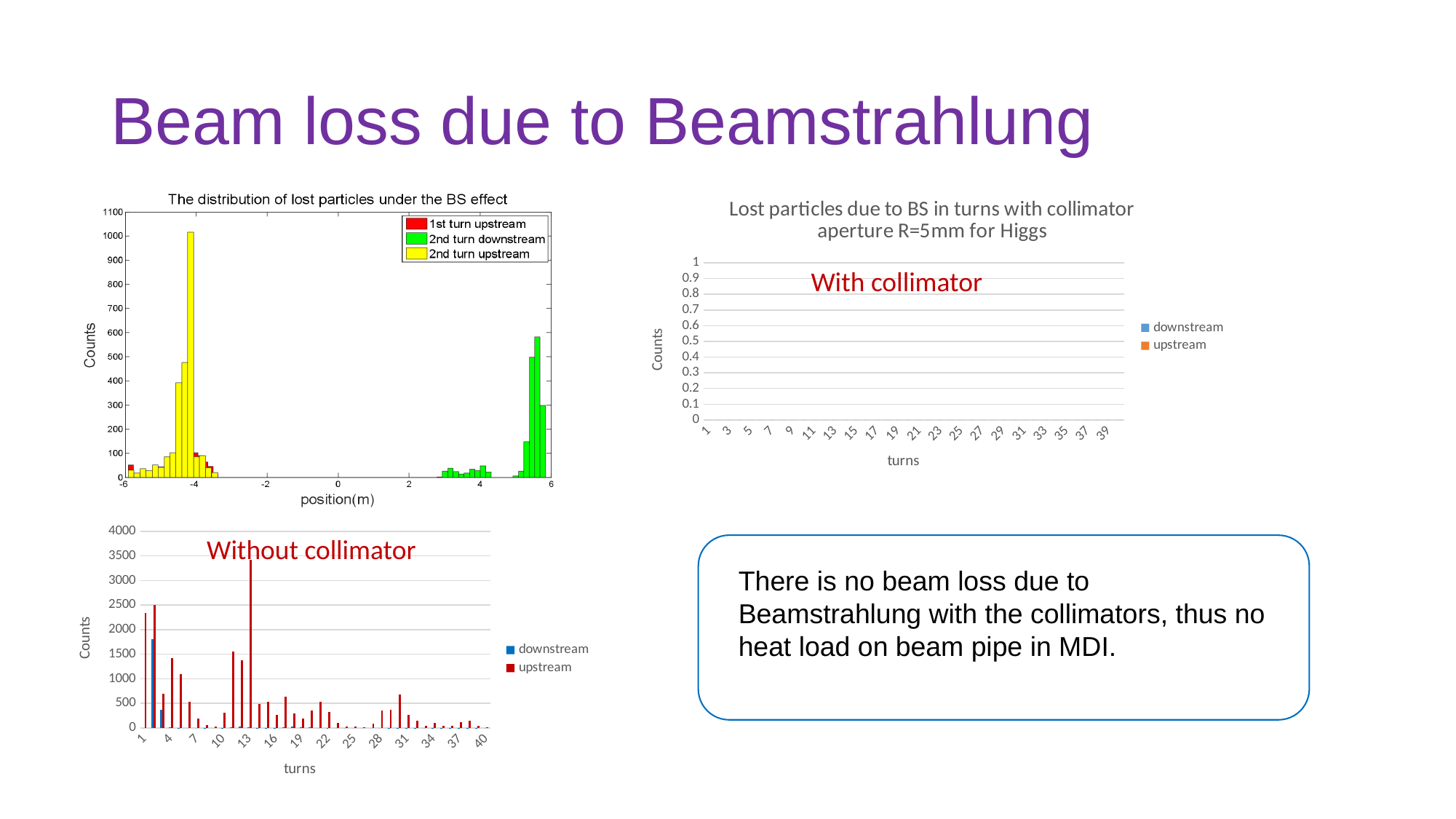
In the chart titled 'The distribution of lost particles under the BS effect', how many series does the legend list? 3 In the chart titled 'The distribution of lost particles under the BS effect', is the tallest '2nd turn downstream' bar greater or less than 500 counts? greater In the chart titled 'Lost particles due to BS in turns with collimator aperture R=5mm for Higgs', how many series does the legend list? 2 In the 'Without collimator' chart at the bottom left, is the downstream bar at turn 1 greater or less than 2000 counts? less In the chart titled 'Lost particles due to BS in turns with collimator aperture R=5mm for Higgs', what is the x-axis label? turns In the 'Without collimator' chart at the bottom left, which is larger: the upstream value at turn 2 or at turn 4? turn 2 What kind of chart is 'The distribution of lost particles under the BS effect'? bar chart In the 'Without collimator' chart at the bottom left, which series has the tallest bar? upstream In the chart titled 'The distribution of lost particles under the BS effect', is the tallest bar greater or less than 900 counts? greater In the chart titled 'The distribution of lost particles under the BS effect', which series has the tallest bar? 2nd turn upstream In the chart titled 'The distribution of lost particles under the BS effect', what is the x-axis label? position(m)